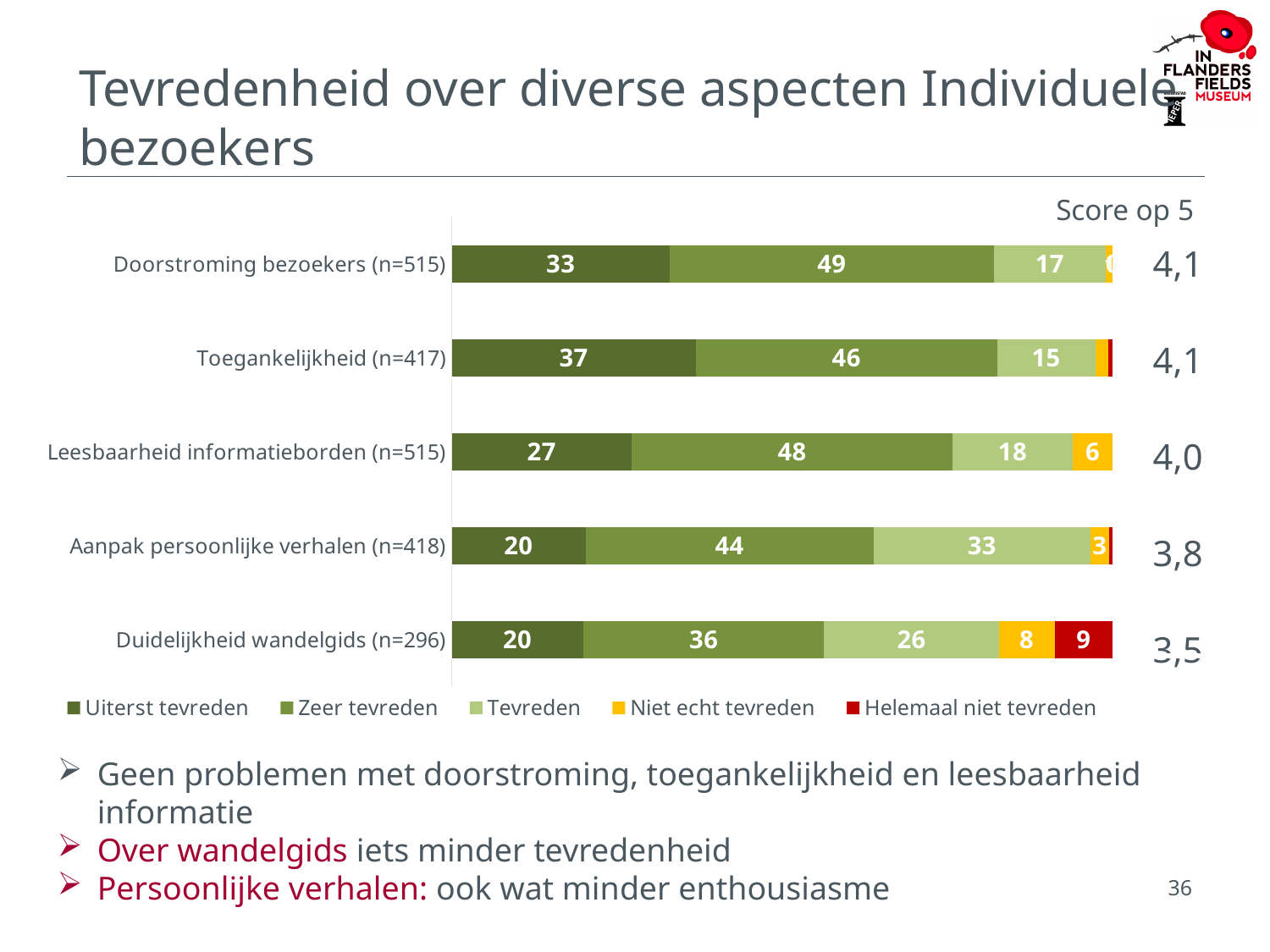
What is the 'Zeer tevreden' value for Doorstroming bezoekers (n=515)? 49 Which is larger: the 'Zeer tevreden' value for Leesbaarheid informatieborden (n=515) or for Duidelijkheid wandelgids (n=296)? Leesbaarheid informatieborden (n=515) What kind of chart is shown on the slide? stacked bar chart What is the 'Uiterst tevreden' value for Toegankelijkheid (n=417)? 37 What is the 'Score op 5' shown for Aanpak persoonlijke verhalen (n=418)? 3,8 What is the difference between the 'Tevreden' values for Aanpak persoonlijke verhalen (n=418) and Toegankelijkheid (n=417)? 18 What is the 'Helemaal niet tevreden' value for Duidelijkheid wandelgids (n=296)? 9 How many categories (aspects) are plotted in the chart? 5 What is the 'Niet echt tevreden' value for Leesbaarheid informatieborden (n=515)? 6 Which category has the lowest 'Score op 5'? Duidelijkheid wandelgids (n=296) How many series does the legend list? 5 Which category has the highest 'Uiterst tevreden' value? Toegankelijkheid (n=417)